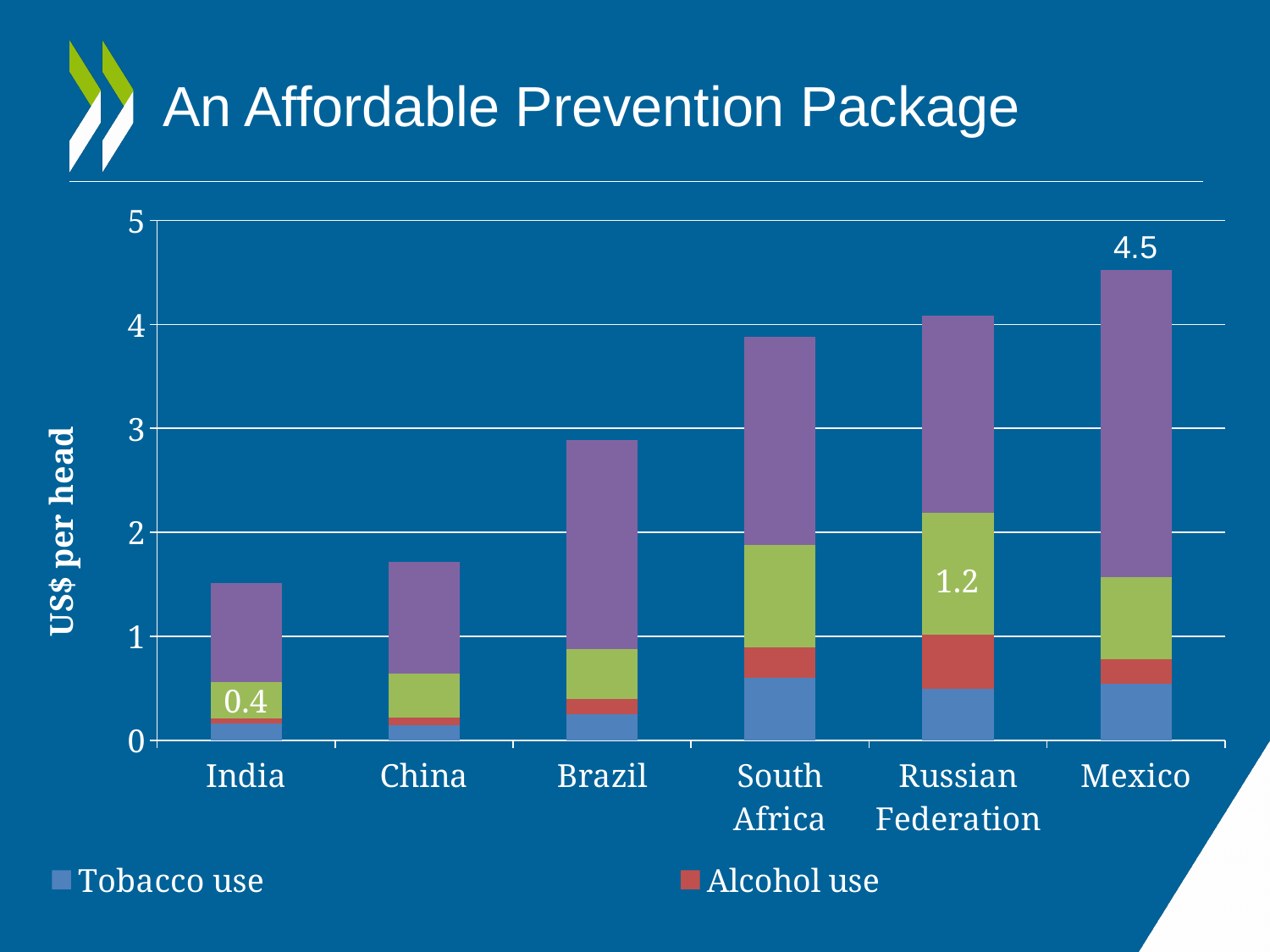
Which country has the shortest bar? India Do the total bar heights rise or fall from India on the left to Mexico on the right? rise Is the total bar height for South Africa greater or less than 3? greater What kind of chart is shown on the slide? bar chart What value is labelled at the top of the Mexico bar? 4.5 How many countries are shown on the x axis of the chart? 6 Which country has the tallest bar? Mexico What value is labelled on the India bar? 0.4 Which has the taller bar, Brazil or China? Brazil How many series does the visible legend list? 2 What value is labelled on the Russian Federation bar? 1.2 Is the total bar height for China greater or less than 2? less